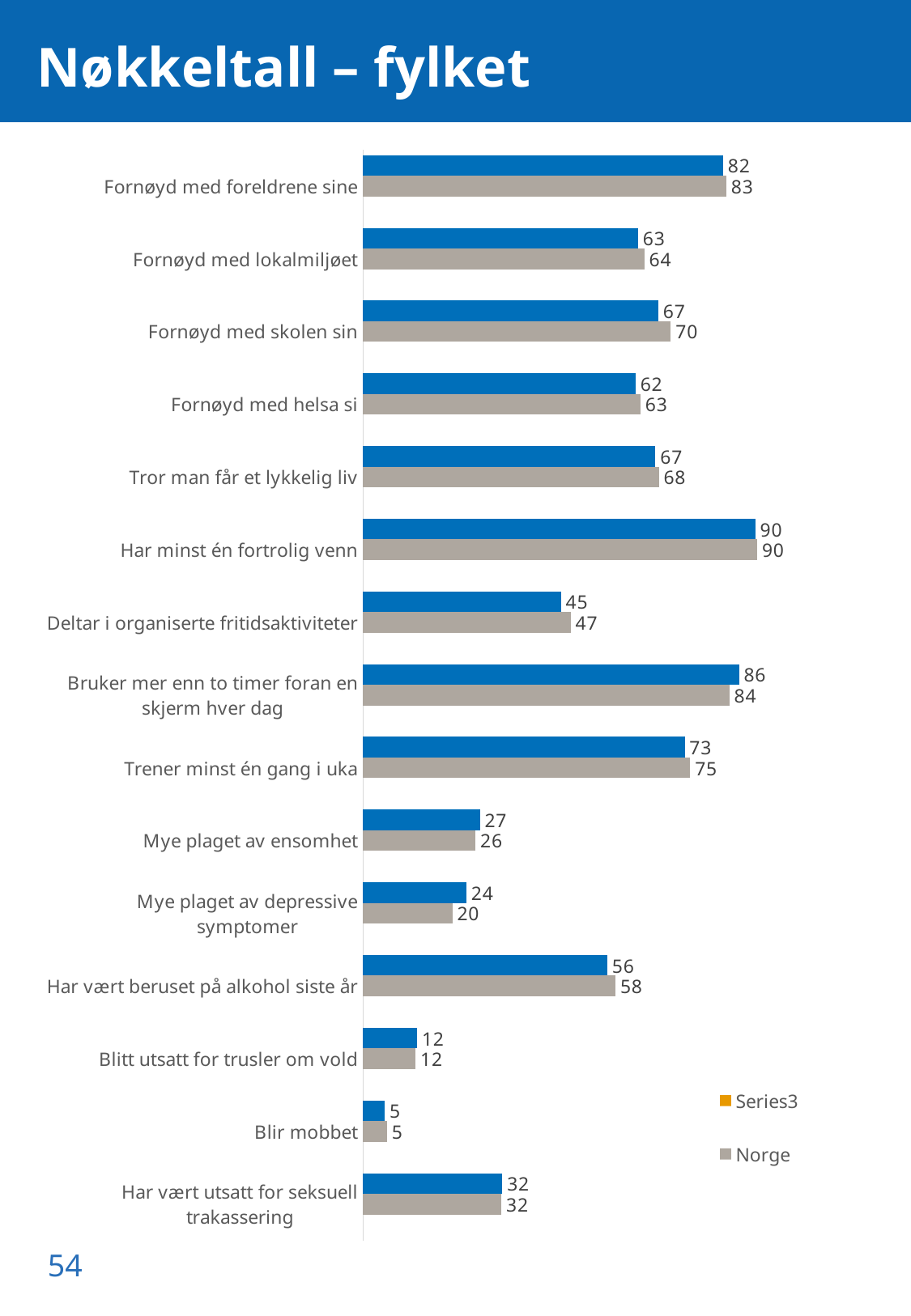
For "Mye plaget av depressive symptomer", what is the difference between the blue bar value and the Norge value? 4 Which category has the highest Norge value? Har minst én fortrolig venn What is the Norge value for "Fornøyd med skolen sin"? 70 What value does the blue bar show for "Bruker mer enn to timer foran en skjerm hver dag"? 86 Which category has the lowest Norge value? Blir mobbet For "Trener minst én gang i uka", which is larger: the blue bar or the Norge bar? Norge For "Fornøyd med skolen sin", how much higher is the Norge value than the blue bar value? 3 How many categories are shown in the chart? 15 How many series does the legend list? 2 What kind of chart is shown on the slide? Bar chart What value does the blue bar show for "Har vært beruset på alkohol siste år"? 56 What is the Norge value for "Deltar i organiserte fritidsaktiviteter"? 47